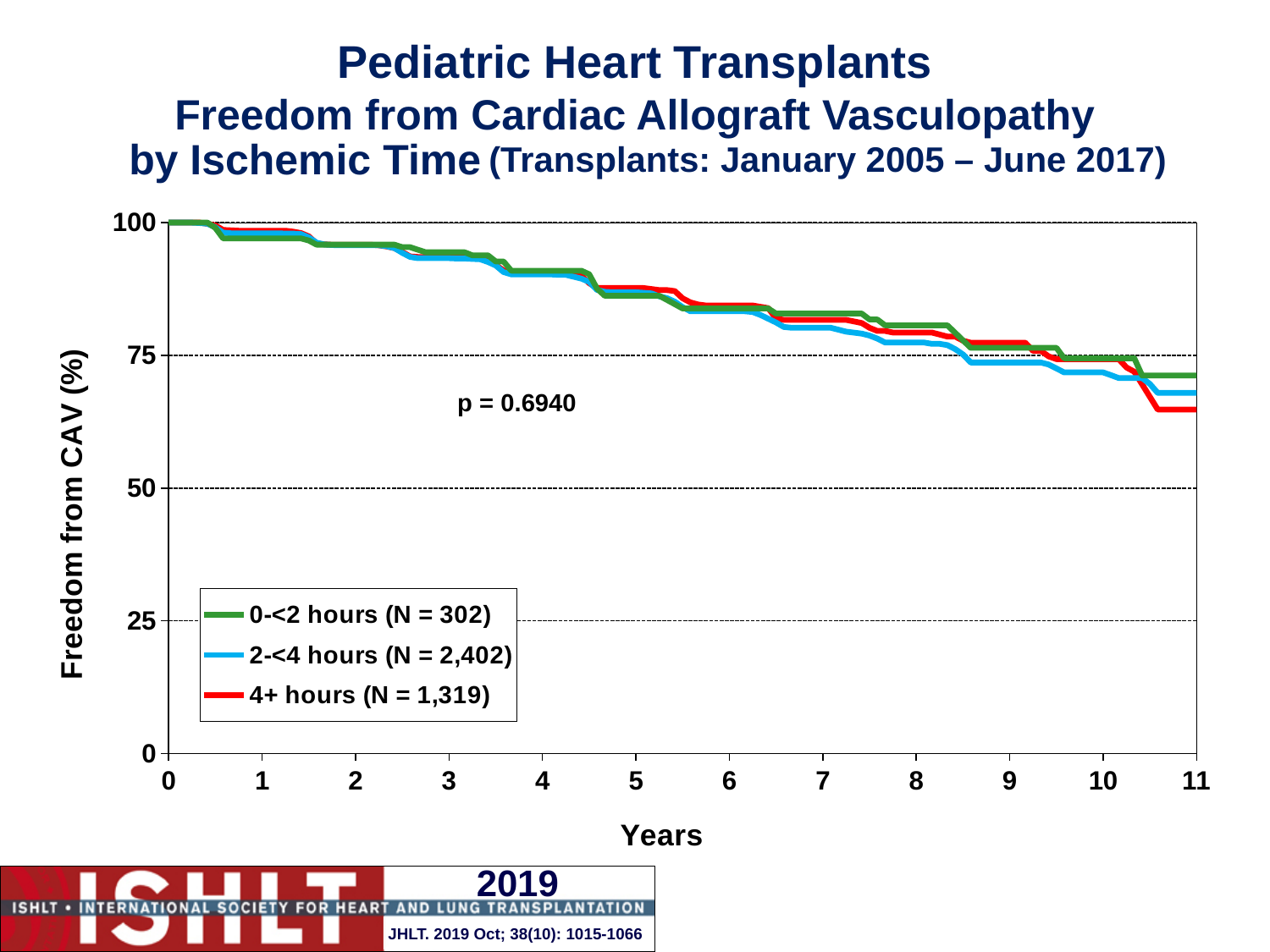
Is the value for the 4+ hours group at 11 years greater or less than 75? less What is the p-value printed on the chart? p = 0.6940 Is the value for the 0-<2 hours group at 5 years greater or less than 75? greater What is the N for the 4+ hours group shown in the legend? N = 1,319 What is the label of the y-axis? Freedom from CAV (%) How many series does the legend list? 3 At 11 years, which is larger: the value for the 0-<2 hours group or the 4+ hours group? 0-<2 hours Which ischemic time group has the lowest freedom from CAV at 11 years? 4+ hours Do the freedom from CAV curves rise or fall as years increase? Fall What is the N for the 2-<4 hours group shown in the legend? N = 2,402 Is the value for the 4+ hours group at 11 years greater or less than 50? greater What kind of chart is shown on the slide? Line chart